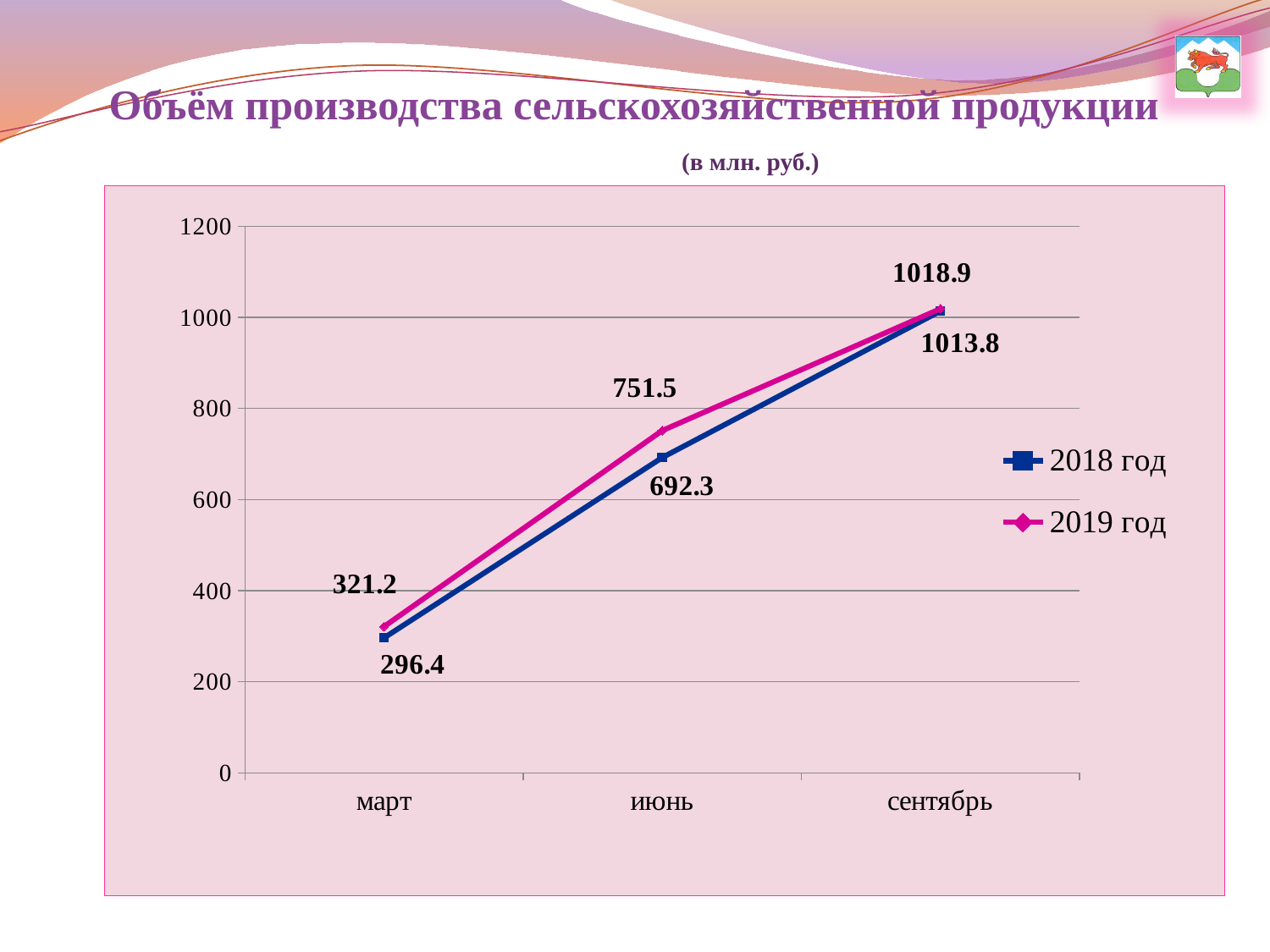
How many series does the legend list? 2 In which month is the value for 2019 год highest? сентябрь What is the value for 2018 год in сентябрь? 1013.8 What is the value for 2019 год in июнь? 751.5 What type of chart is shown on the slide? line chart How many categories are shown on the x axis? 3 What is the difference between the 2019 год and 2018 год values in июнь? 59.2 In which month is the value for 2018 год lowest? март Do the values for 2018 год rise or fall from март to сентябрь? rise What is the value for 2018 год in март? 296.4 Which series has the larger value in март, 2018 год or 2019 год? 2019 год What is the value for 2019 год in март? 321.2